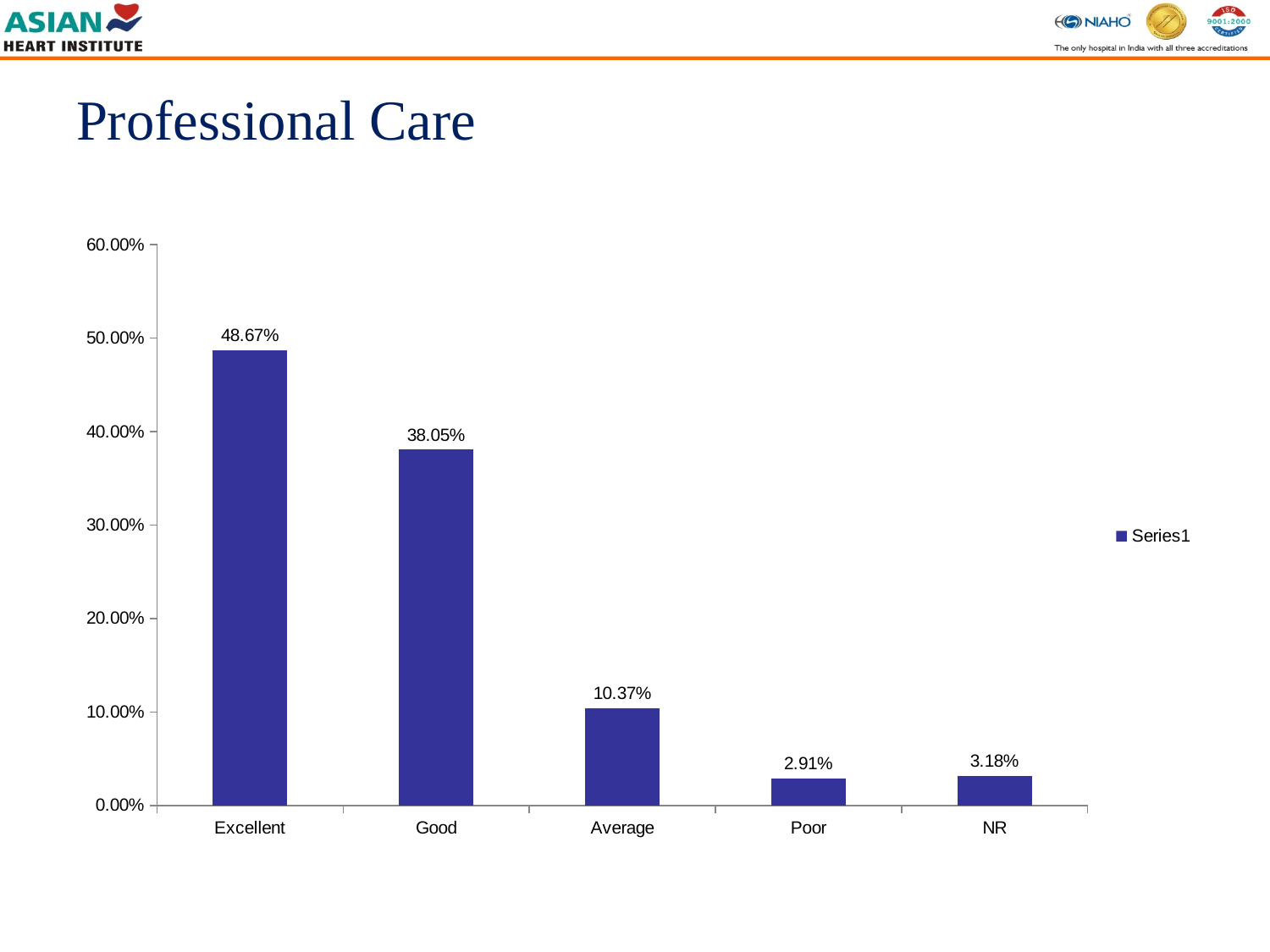
What is the value for Good? 38.05% What is the value for Excellent? 48.67% How many categories are shown on the x axis? 5 Which is larger, the value for Average or the value for NR? Average What is the value for NR? 3.18% What is the value for Average? 10.37% Which category has the lowest value? Poor What is the difference between the values for Excellent and Good? 10.62% Which category has the highest value? Excellent What kind of chart is shown on the slide? bar chart What is the title of the slide containing the chart? Professional Care Is the value for Good greater or less than 40.00%? less